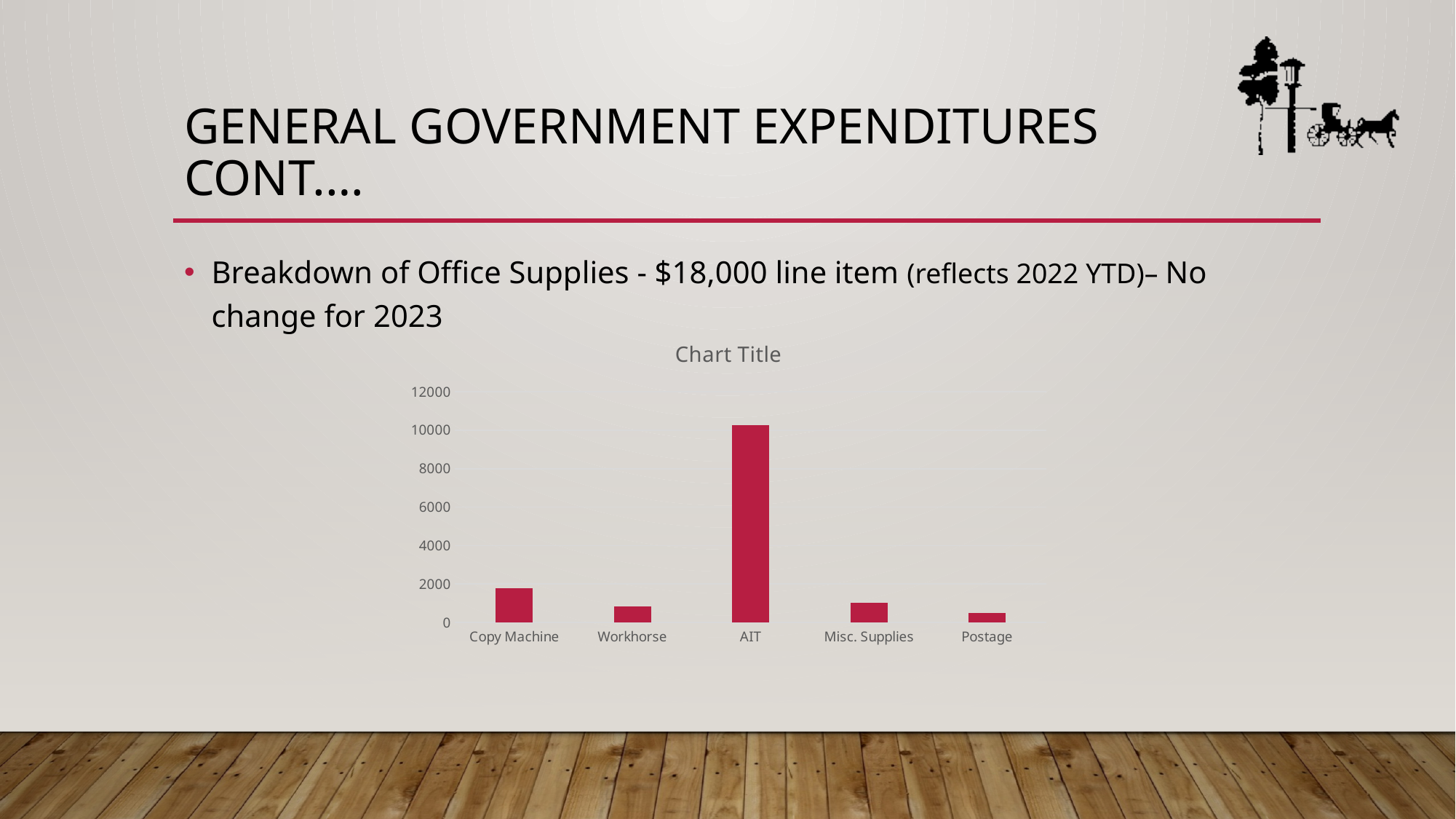
Is the value for Copy Machine greater or less than 4000? less What kind of chart is shown on the slide? bar chart What is the highest value shown on the chart's vertical axis? 12000 Which is larger, the value for Copy Machine or the value for Workhorse? Copy Machine Is the value for Misc. Supplies greater or less than 2000? less Which category has the highest value in the chart? AIT What is the title shown above the chart? Chart Title Which category has the lowest value in the chart? Postage How many categories are shown on the x axis of the chart? 5 Which is larger, the value for AIT or the value for Copy Machine? AIT Is the value for AIT greater or less than 8000? greater